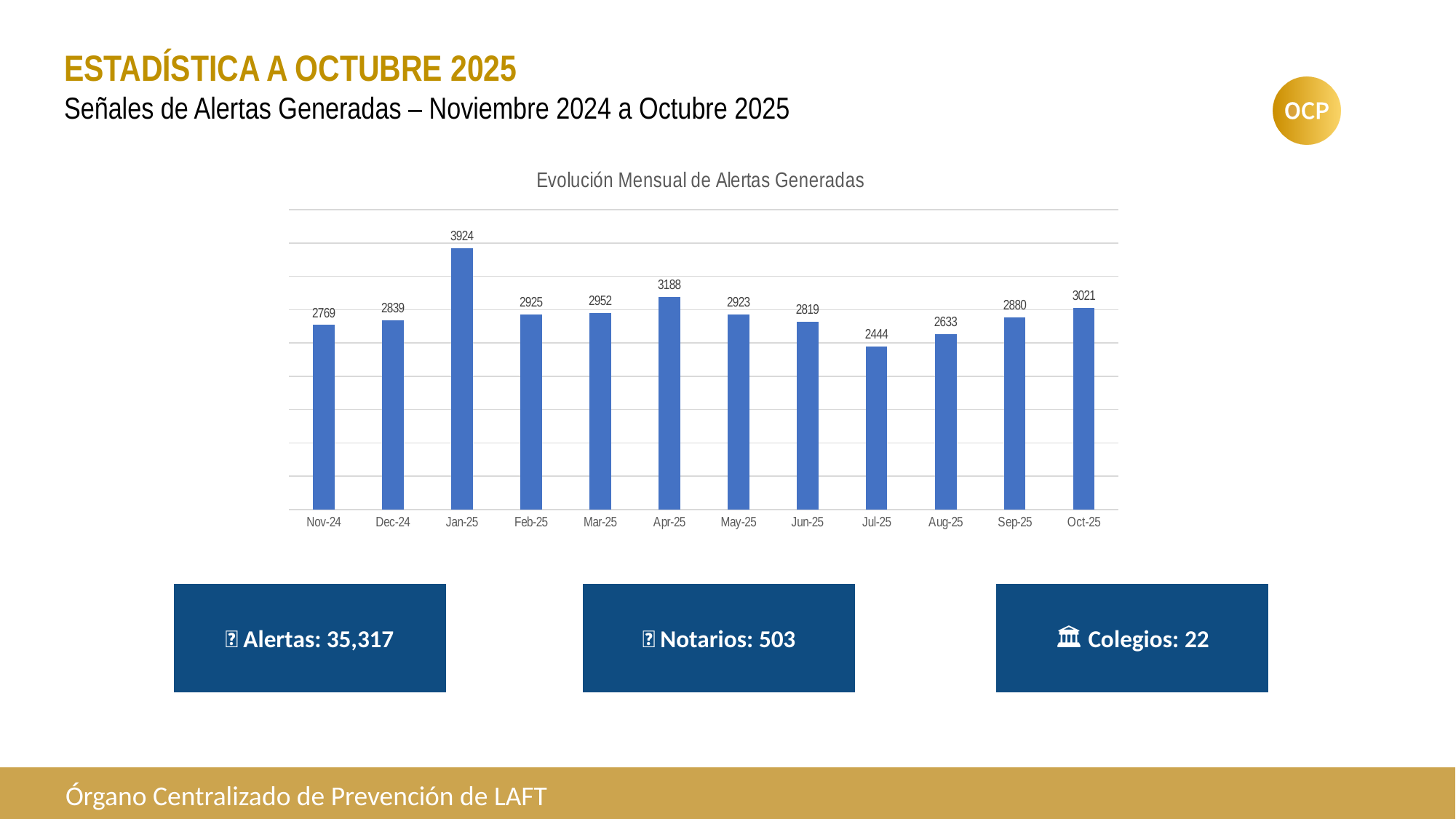
How many months are shown in the chart? 12 What is the value for Oct-25 in the chart? 3021 What is the title of the chart? Evolución Mensual de Alertas Generadas Do the values rise or fall from Jul-25 to Oct-25? Rise Which month has the highest value in the chart? Jan-25 Which is larger, the value for Apr-25 or the value for Mar-25? Apr-25 What is the value for Jul-25 in the chart? 2444 What is the difference between the values for Oct-25 and Sep-25? 141 What is the value for Jan-25 in the chart? 3924 What is the difference between the values for Jan-25 and Jul-25? 1480 What kind of chart is shown on the slide? Bar chart Which month has the lowest value in the chart? Jul-25